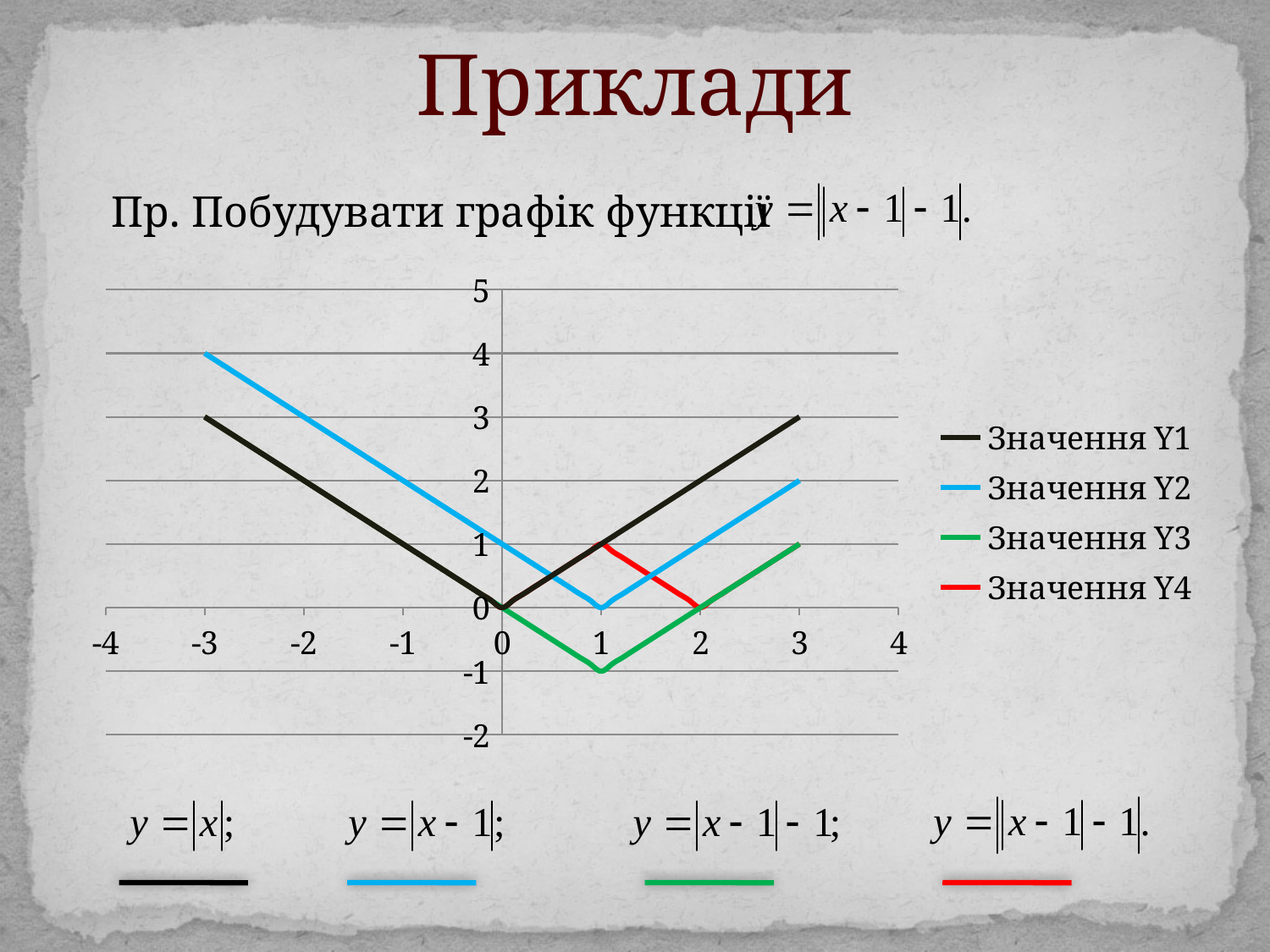
Is the value of Значення Y2 at x = -3 greater or less than 3? greater What is the value of Значення Y3 at x = 1? -1 What is the difference between Значення Y2 and Значення Y1 at x = -3? 1 At which x value does Значення Y3 reach its lowest point? 1 At which x value does Значення Y2 reach its highest point? -3 What is the value of Значення Y1 at x = -3? 3 What is the value of Значення Y2 at x = -3? 4 What kind of chart is shown on the slide? line chart Which colour is used for the series Значення Y4? red At x = 3, which is larger: Значення Y1 or Значення Y2? Значення Y1 What is the value of Значення Y4 at x = 2? 0 How many series does the legend list? 4